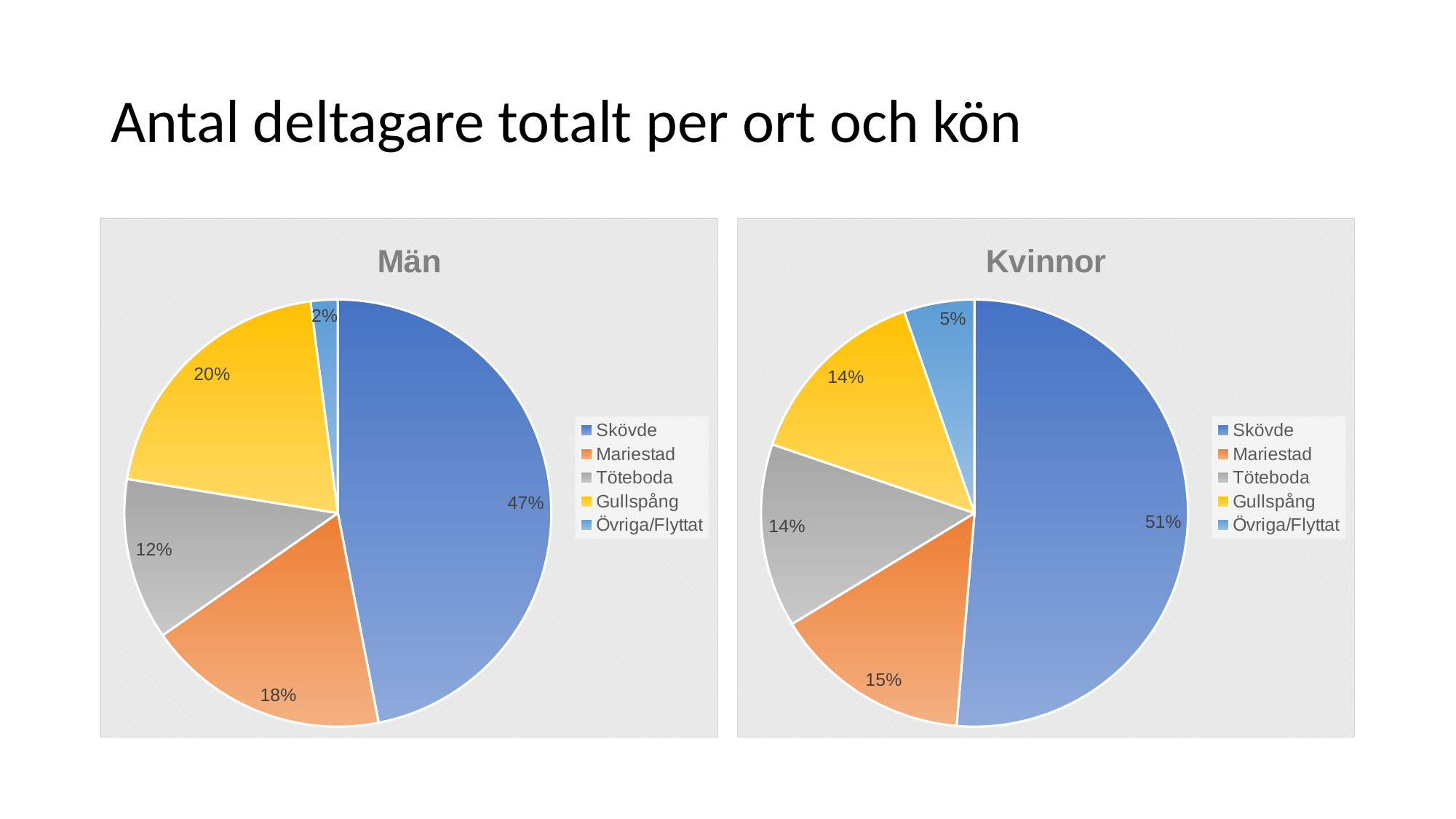
In the 'Män' pie chart, which category has the smallest slice? Övriga/Flyttat In the 'Kvinnor' pie chart, what is the value for Mariestad? 15% In the 'Kvinnor' pie chart, what colour is the Gullspång slice? Yellow In the 'Män' pie chart, which is larger, Mariestad or Töteboda? Mariestad In the 'Kvinnor' pie chart, which category has the largest slice? Skövde In the 'Män' pie chart, what is the value for Gullspång? 20% How many categories does the legend of the 'Kvinnor' chart list? 5 What type of chart is the 'Män' chart? Pie chart In the 'Kvinnor' pie chart, what is the difference between the Skövde and Övriga/Flyttat shares? 46% In the 'Män' pie chart, what is the difference between the Gullspång and Töteboda shares? 8% In the 'Kvinnor' pie chart, what share does Skövde have? 51% In the 'Män' pie chart, what share does Skövde have? 47%